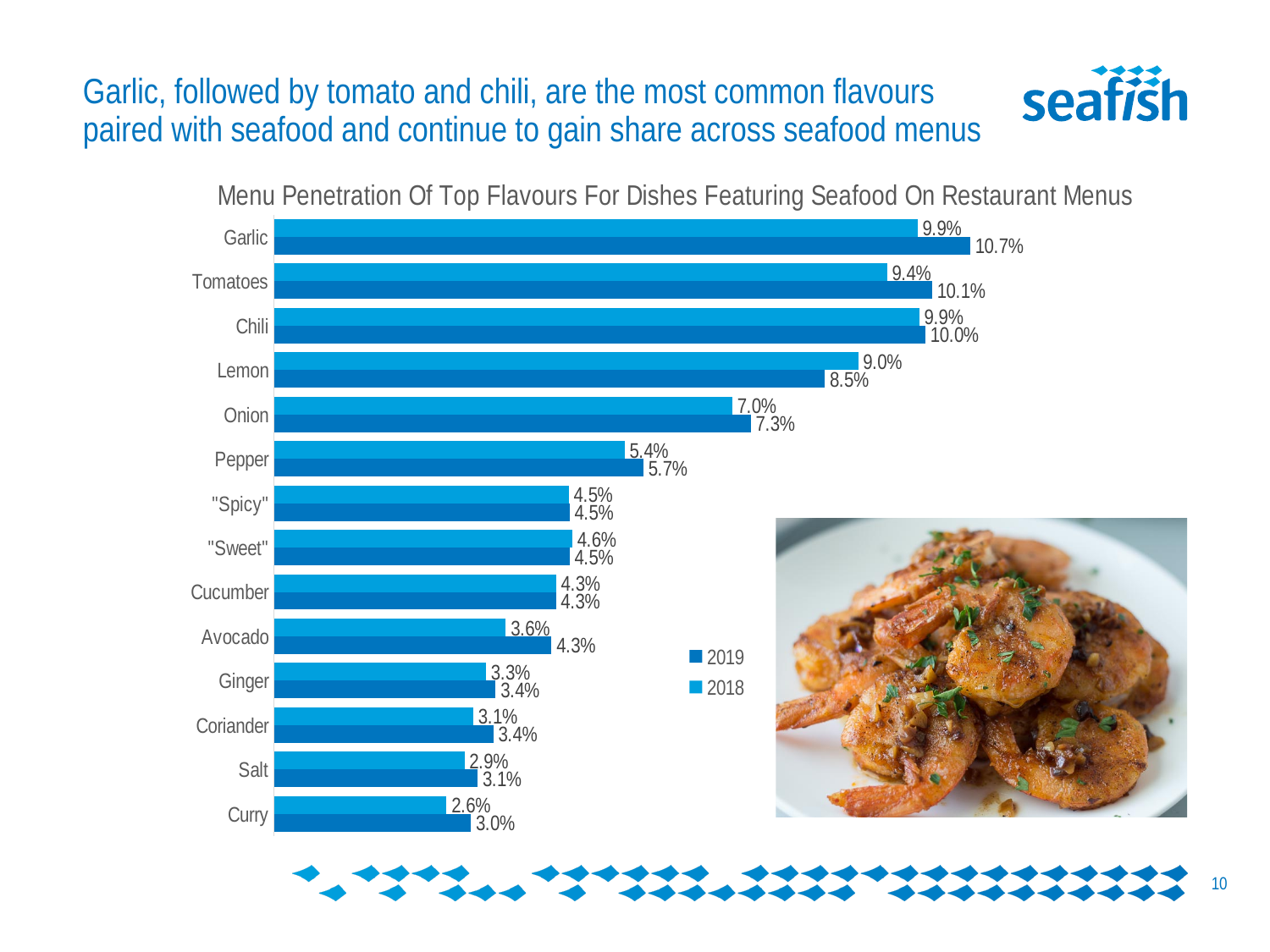
Which is larger for Avocado, the 2018 value or the 2019 value? 2019 How many series does the legend list? 2 What is the difference between the 2019 values for Tomatoes and Onion? 2.8% What is the difference between the 2019 and 2018 values for Garlic? 0.8% What is the 2019 value for Garlic? 10.7% Which flavour has the highest 2019 value? Garlic What is the 2018 value for Lemon? 9.0% What is the 2019 value for Curry? 3.0% How many flavour categories are shown in the chart? 14 Which flavour has the lowest 2018 value? Curry What is the title of the chart? Menu Penetration Of Top Flavours For Dishes Featuring Seafood On Restaurant Menus What type of chart is shown on the slide? Bar chart